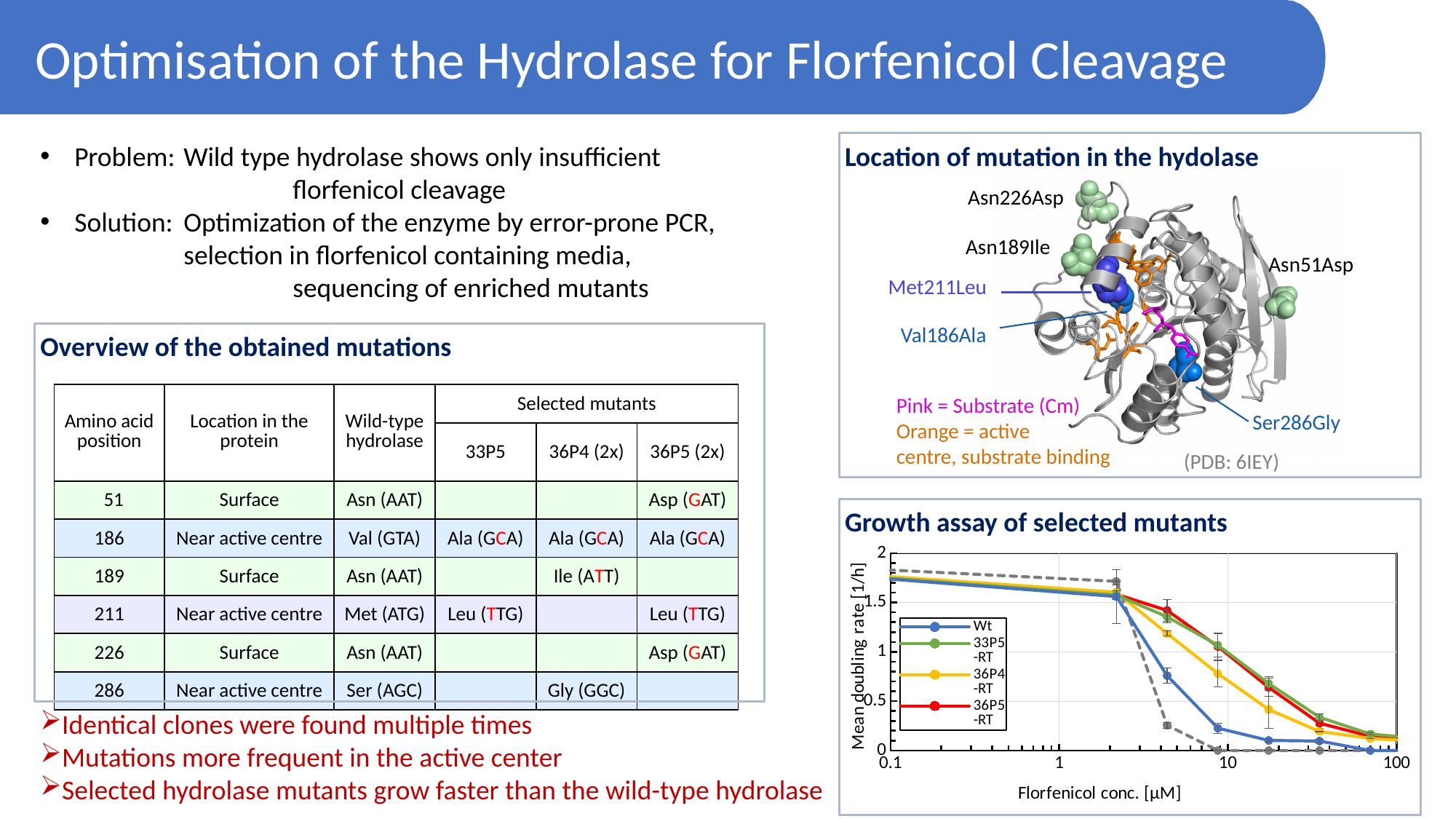
In the 'Growth assay of selected mutants' chart, at the point around 4 µM, which series has the higher mean doubling rate: Wt or 36P5-RT? 36P5-RT In the 'Growth assay of selected mutants' chart, is the Wt value at 0.1 µM greater or less than 1.5? greater How many series does the legend of the 'Growth assay of selected mutants' chart list? 4 In the 'Growth assay of selected mutants' chart, at the point just below 10 µM, which series has the higher mean doubling rate: Wt or 33P5-RT? 33P5-RT What kind of chart is the 'Growth assay of selected mutants' chart? line chart What is the x-axis label of the 'Growth assay of selected mutants' chart? Florfenicol conc. [µM] In the 'Growth assay of selected mutants' chart, is the Wt value at the point just below 10 µM greater or less than 0.5? less What is the y-axis label of the 'Growth assay of selected mutants' chart? Mean doubling rate [1/h] In the 'Growth assay of selected mutants' chart, do the mean doubling rates rise or fall as florfenicol concentration increases? fall In the 'Growth assay of selected mutants' chart, is the 36P4-RT value at the point just below 10 µM greater or less than 0.5? greater